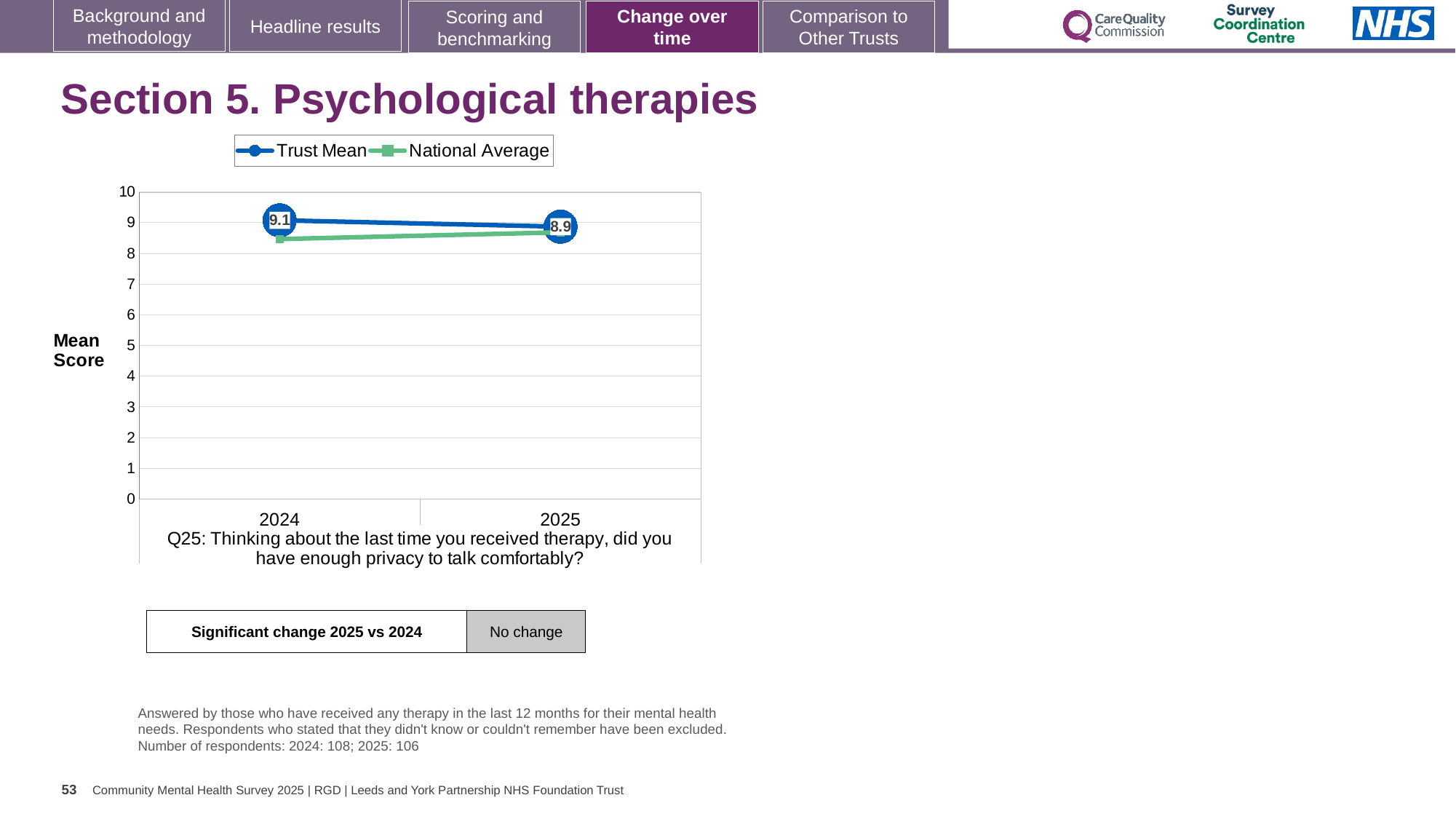
How many years are shown on the x axis of the chart? 2 What is the Trust Mean score for 2024? 9.1 How many series does the chart legend list? 2 In which year is the Trust Mean highest? 2024 What kind of chart is shown on the slide? line chart Is the National Average value for 2025 greater or less than 9? less In 2024, which is larger: the Trust Mean or the National Average? Trust Mean Does the Trust Mean rise or fall from 2024 to 2025? fall What is the difference between the Trust Mean in 2024 and in 2025? 0.2 What is the Trust Mean score for 2025? 8.9 Is the National Average value for 2024 greater or less than 8? greater In which year is the Trust Mean lowest? 2025